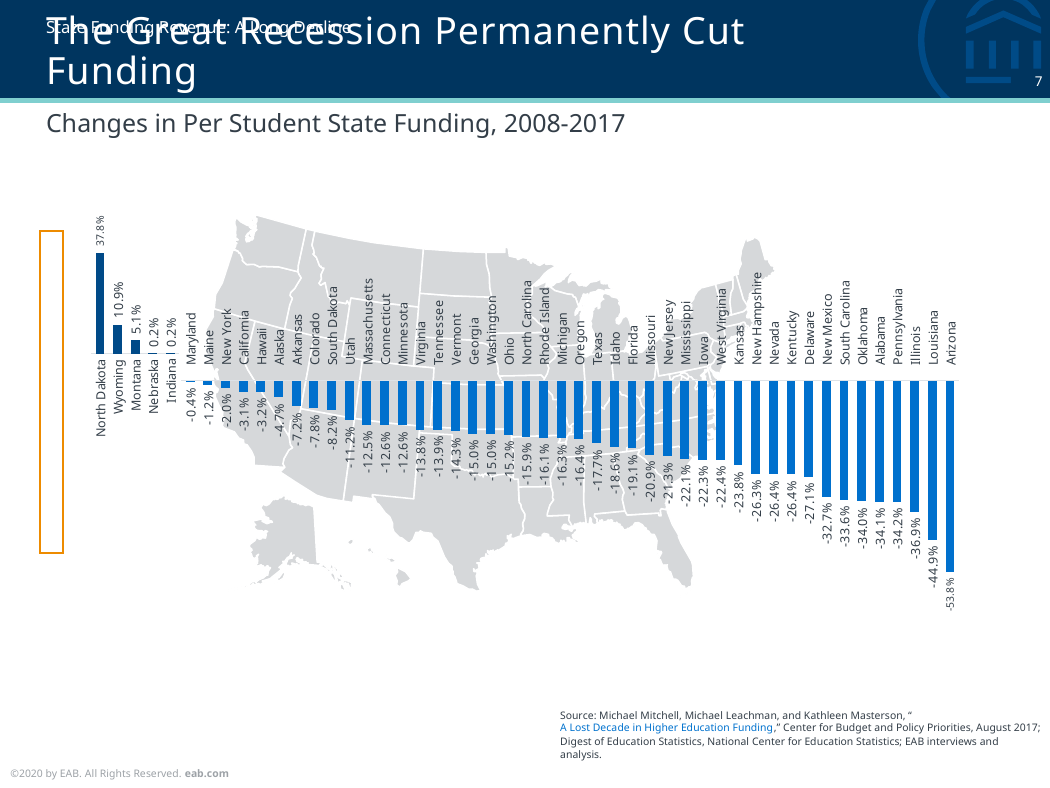
What is the subtitle of the chart? Changes in Per Student State Funding, 2008-2017 What is the change in per student state funding for Texas? -17.7% Do the values rise or fall moving from left to right across the states? Fall What is the difference between the values for North Dakota and Wyoming? 26.9 percentage points What is the change in per student state funding for Arizona? -53.8% Which state has the highest change in per student state funding? North Dakota What kind of chart is shown on the slide? Bar chart What is the change in per student state funding for North Dakota? 37.8% What is the change in per student state funding for Illinois? -36.9% What is the difference between the values for Louisiana and Arizona? 8.9 percentage points Which state has the lowest change in per student state funding? Arizona